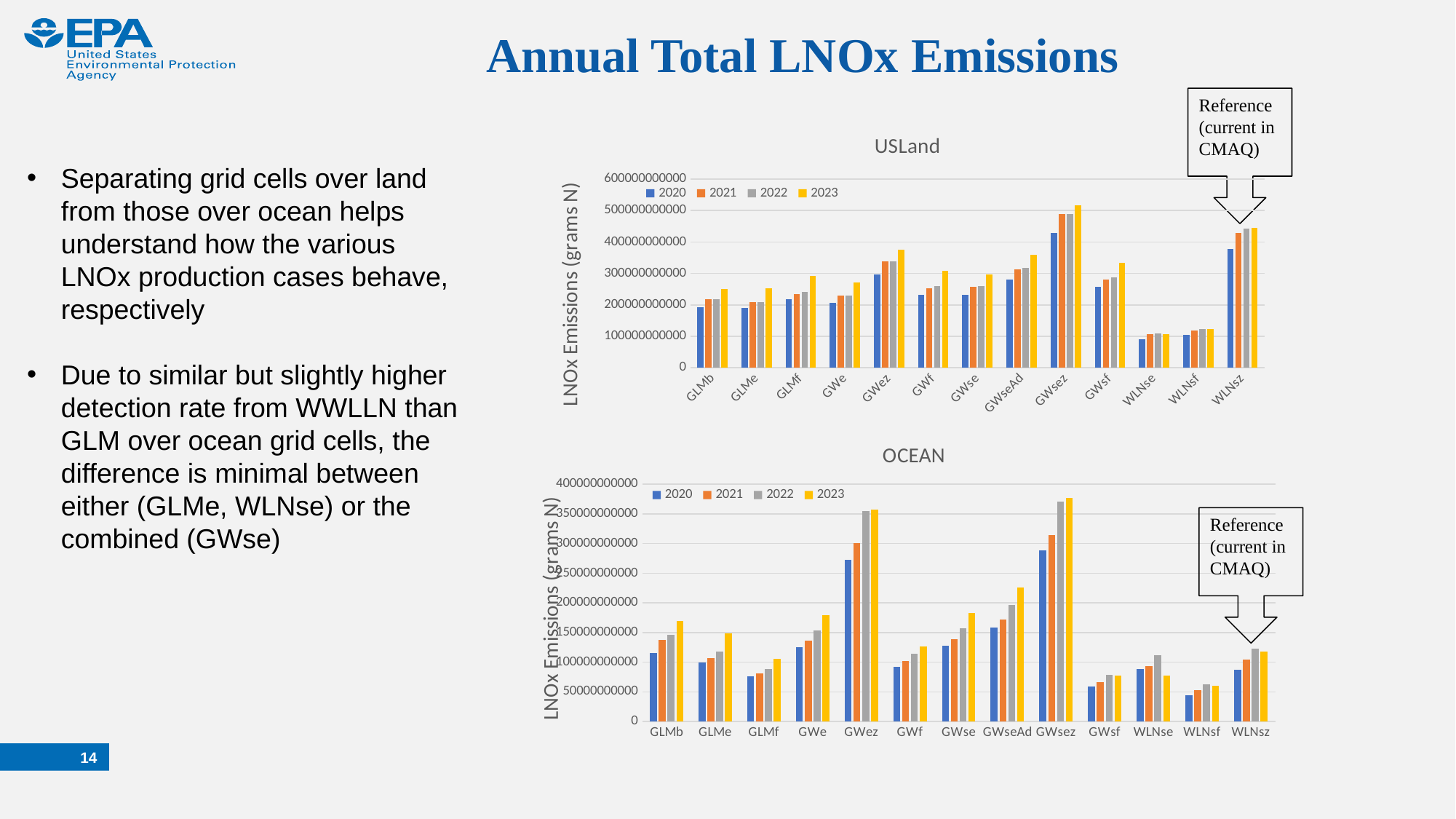
In the OCEAN chart, which category has the highest bar? GWsez In the OCEAN chart, is the 2020 value for WLNsf greater or less than 50000000000? less How many categories are shown on the x axis of the OCEAN chart? 13 In the OCEAN chart, which category has the lowest bar? WLNsf What kind of chart is the USLand chart? bar chart In the USLand chart, is the 2023 value for GWez greater or less than 300000000000? greater How many series does the legend of the USLand chart list? 4 In the USLand chart, do the GWsez values rise or fall from 2020 to 2023? rise In the USLand chart, which category has the lowest bars? WLNse In the USLand chart, is the 2020 value for WLNse greater or less than 100000000000? less In the OCEAN chart, which is larger for 2023: GWez or GWsez? GWsez In the USLand chart, which category has the highest bar? GWsez